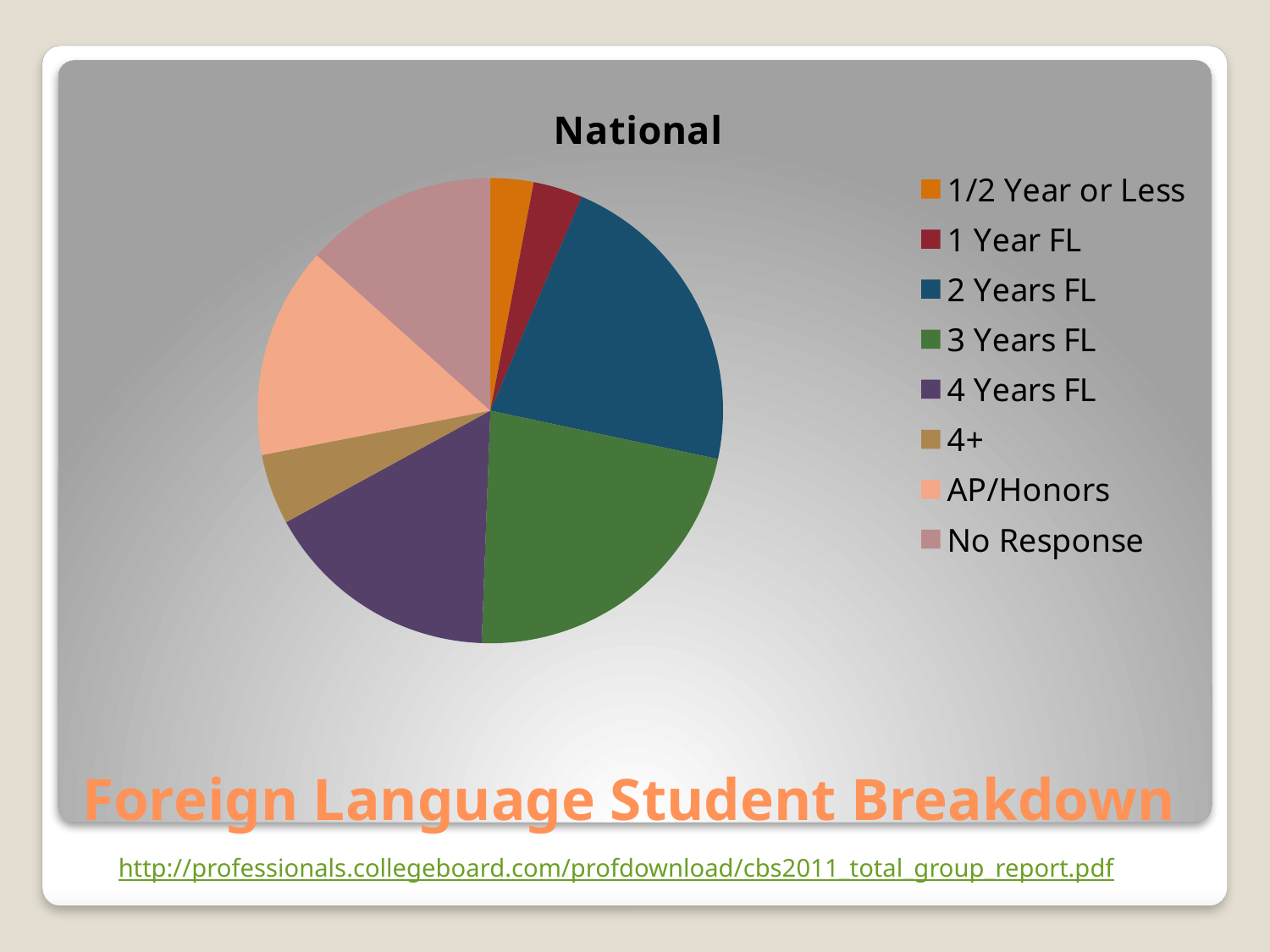
What colour is the slice for 2 Years FL? blue What kind of chart is shown on the slide? pie chart How many entries does the legend list? 8 Which is larger, the slice for 3 Years FL or the slice for 1 Year FL? 3 Years FL Which is larger, the slice for 2 Years FL or the slice for No Response? 2 Years FL Which is larger, the slice for AP/Honors or the slice for 4+? AP/Honors How many slices does the pie chart have? 8 What is the title of the pie chart? National